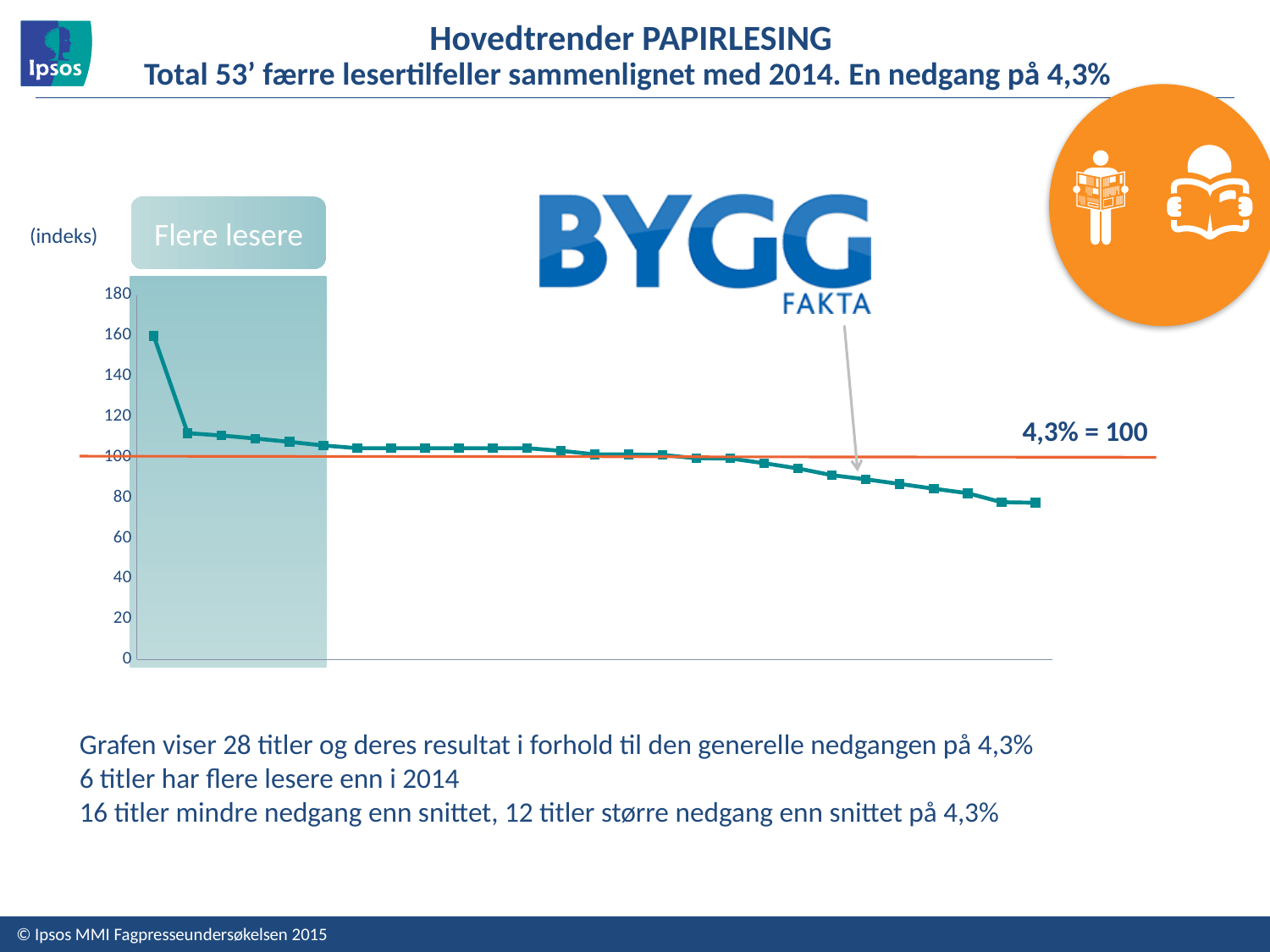
At what index value is the horizontal reference line drawn? 100 Do the plotted values rise or fall from left to right along the x axis? fall Which is larger: the value of the leftmost point or the value of the rightmost point? leftmost point Which point is the highest: the leftmost or the rightmost? leftmost What is the highest value shown on the y axis? 180 Is the value of the second point from the left greater or less than 100? greater What kind of chart is shown on the slide? line chart Is the value of the first (leftmost) point greater or less than 140? greater Is the value of the last (rightmost) point greater or less than 80? less What label is shown on the shaded area at the left of the chart? Flere lesere How many titles (data points) does the chart show? 28